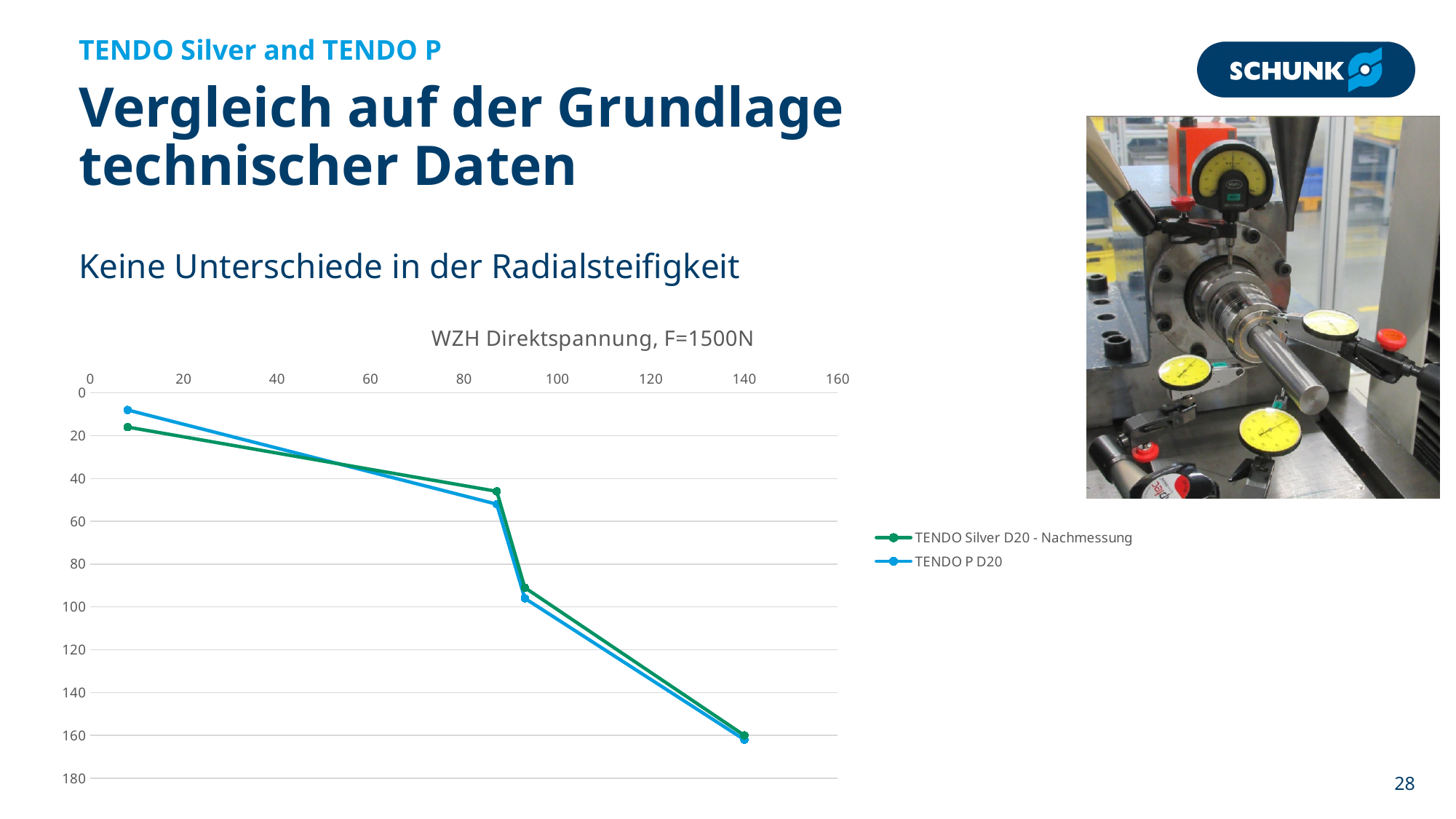
How many data points does the TENDO P D20 series have? 4 How many data points does the TENDO Silver D20 - Nachmessung series have? 4 Is the value of the last (rightmost) point of the TENDO Silver D20 - Nachmessung series greater or less than 140? greater Do the plotted values of the TENDO P D20 series increase or decrease as the x-axis value increases? increase Which two series are listed in the chart legend? TENDO Silver D20 - Nachmessung and TENDO P D20 At the leftmost data point, which series has the larger plotted value: TENDO Silver D20 - Nachmessung or TENDO P D20? TENDO Silver D20 - Nachmessung What is the title of the chart? WZH Direktspannung, F=1500N How many series does the chart legend list? 2 Is the value of the second point of the TENDO Silver D20 - Nachmessung series greater or less than 60? less Is the value of the first (leftmost) point of the TENDO P D20 series greater or less than 20? less What kind of chart is shown on the slide? line chart At the second data point (around x = 87), which series has the larger plotted value: TENDO Silver D20 - Nachmessung or TENDO P D20? TENDO P D20